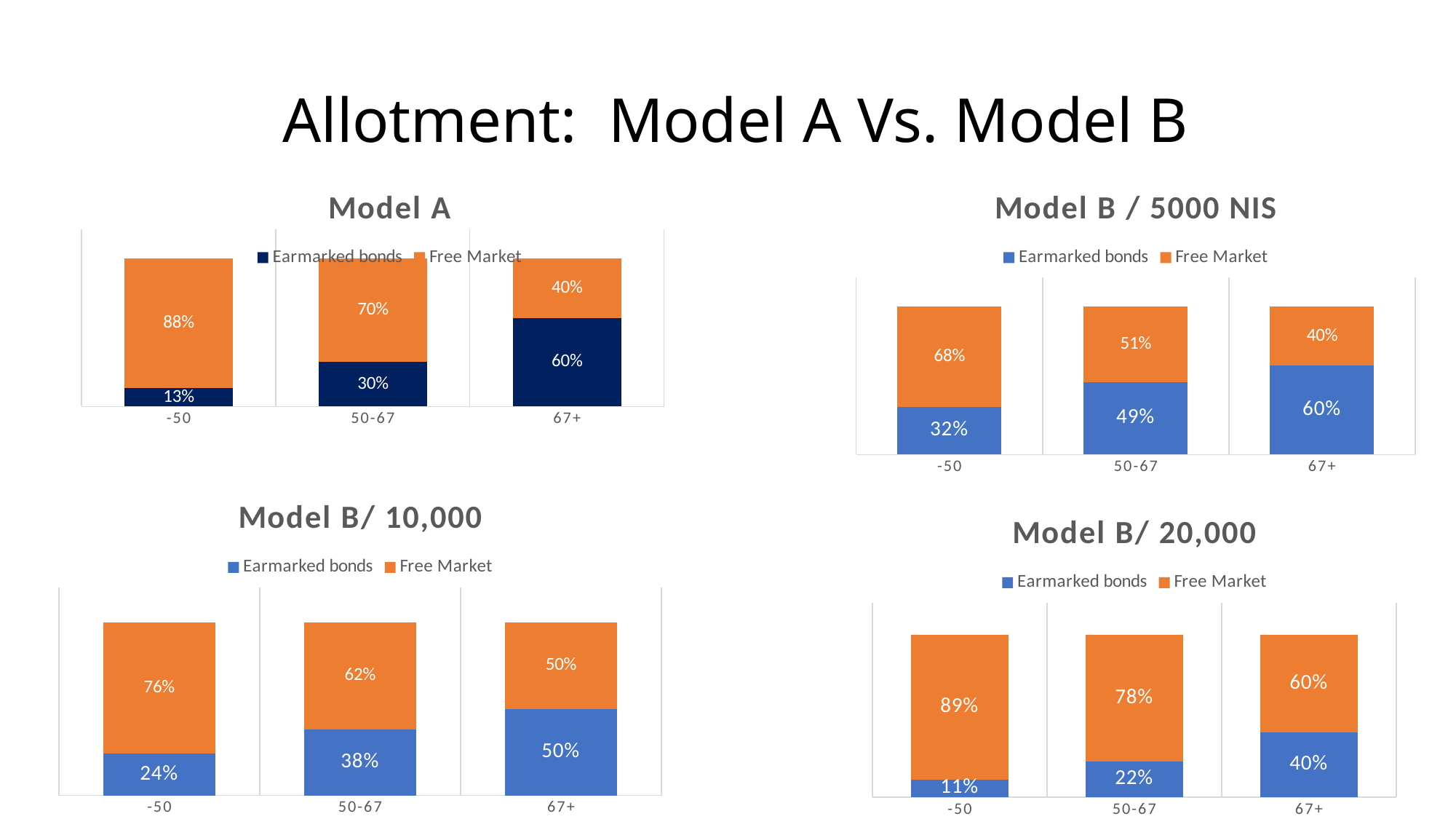
In the Model B/ 10,000 chart, which is larger: the Earmarked bonds value for 50-67 or for 67+? 67+ In the Model B/ 20,000 chart, what is the Earmarked bonds value for the 67+ category? 40% In the Model A chart, what is the Earmarked bonds value for the -50 category? 13% In the Model A chart, what is the Free Market value for the 50-67 category? 70% In the Model A chart, what is the difference between the Free Market values for -50 and 67+? 48% How many series does the legend of the Model A chart list? 2 How many categories are shown on the x axis of the Model B/ 20,000 chart? 3 In the Model B / 5000 NIS chart, what is the Earmarked bonds value for the 50-67 category? 49% In the Model B/ 10,000 chart, what is the Free Market value for the -50 category? 76% In the Model B / 5000 NIS chart, which category has the lowest Earmarked bonds value? -50 What kind of chart is the Model B / 5000 NIS chart? Stacked bar chart In the Model B/ 20,000 chart, which category has the highest Free Market value? -50